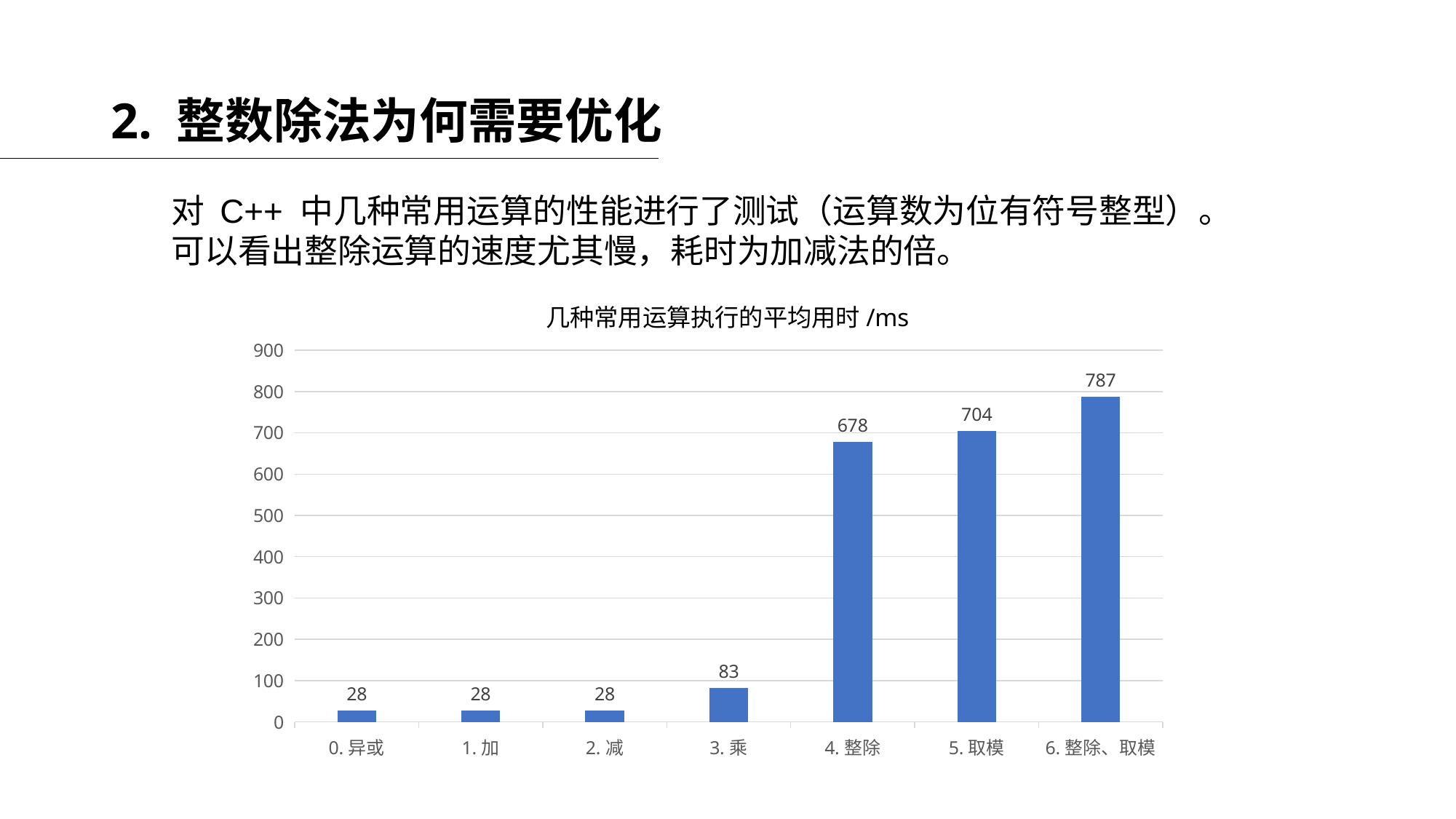
What is the difference between the values for 6. 整除、取模 and 4. 整除? 109 What is the value for 5. 取模? 704 Which category has the highest value? 6. 整除、取模 What is the value for 4. 整除? 678 Which is larger, the value for 5. 取模 or the value for 4. 整除? 5. 取模 Is the value for 4. 整除 greater or less than 600? greater What kind of chart is shown on the slide? bar chart How many categories are shown on the x axis? 7 What is the title of the chart? 几种常用运算执行的平均用时 /ms What is the difference between the values for 3. 乘 and 1. 加? 55 What is the value for 3. 乘? 83 What is the value for 0. 异或? 28